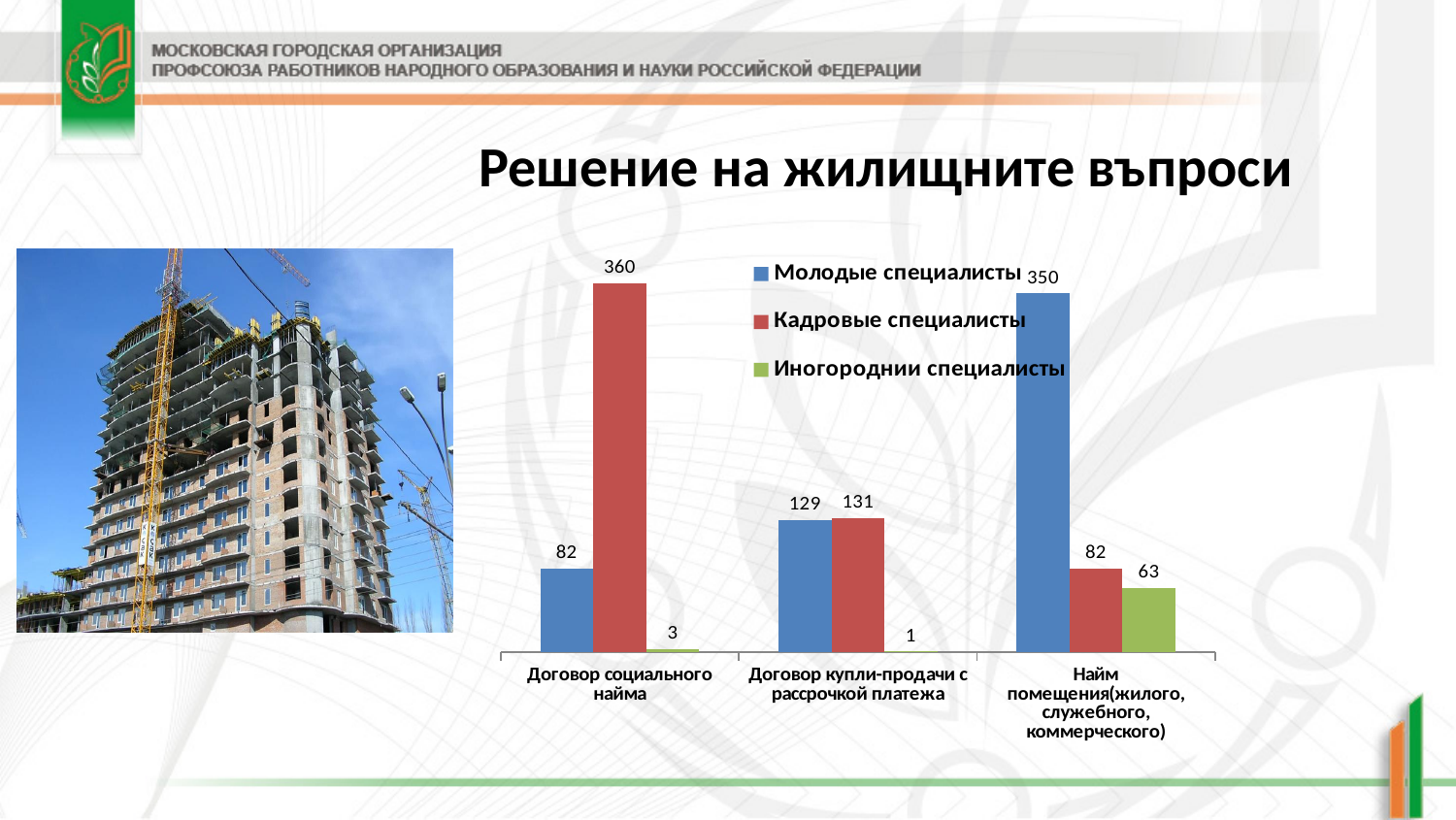
What is the title of the slide containing the chart? Решение на жилищните въпроси What is the difference between Кадровые специалисты and Молодые специалисты in the Договор социального найма category? 278 What is the value for Кадровые специалисты in the Договор социального найма category? 360 What is the value for Иногородние специалисты in the Договор купли-продажи с рассрочкой платежа category? 1 What kind of chart is shown on the slide? Bar chart Which is larger in the Найм помещения category: Молодые специалисты or Кадровые специалисты? Молодые специалисты What is the value for Иногородние специалисты in the Найм помещения category? 63 How many categories are shown on the x axis of the chart? 3 How many series does the legend list? 3 Which category has the lowest value for Иногородние специалисты? Договор купли-продажи с рассрочкой платежа Which category has the highest value for Молодые специалисты? Найм помещения (жилого, служебного, коммерческого) What is the value for Молодые специалисты in the Найм помещения (жилого, служебного, коммерческого) category? 350